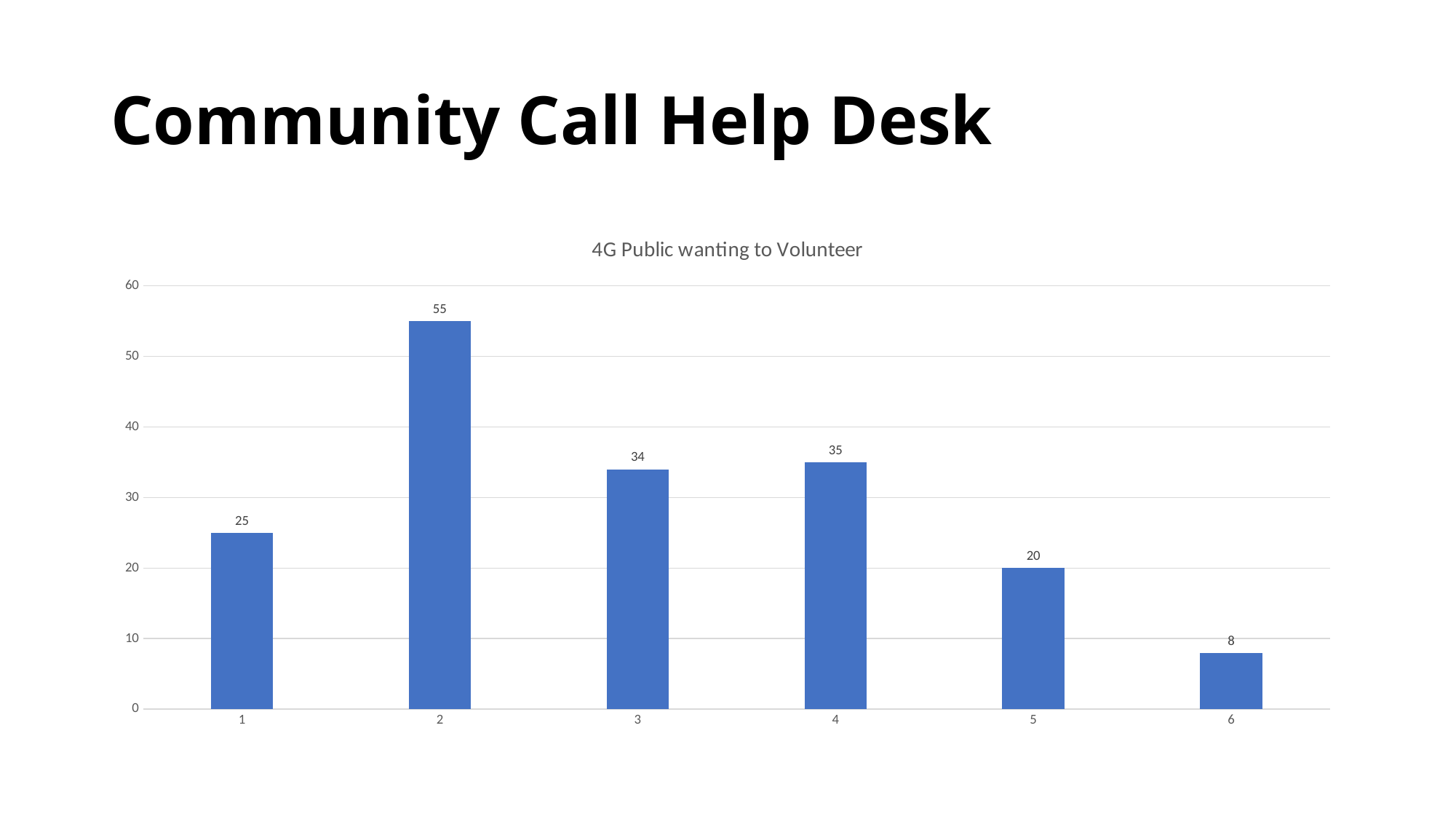
What is the value for category 2? 55 What is the difference between the values for category 2 and category 1? 30 What is the difference between the values for category 5 and category 6? 12 Which category has the lowest value? 6 What is the value for category 6? 8 What is the title of the chart? 4G Public wanting to Volunteer Which is larger, the value for category 1 or the value for category 5? category 1 How many categories are shown on the x axis? 6 Which category has the highest value? 2 What kind of chart is shown on the slide? bar chart Is the value for category 3 greater or less than 30? greater What is the value for category 4? 35